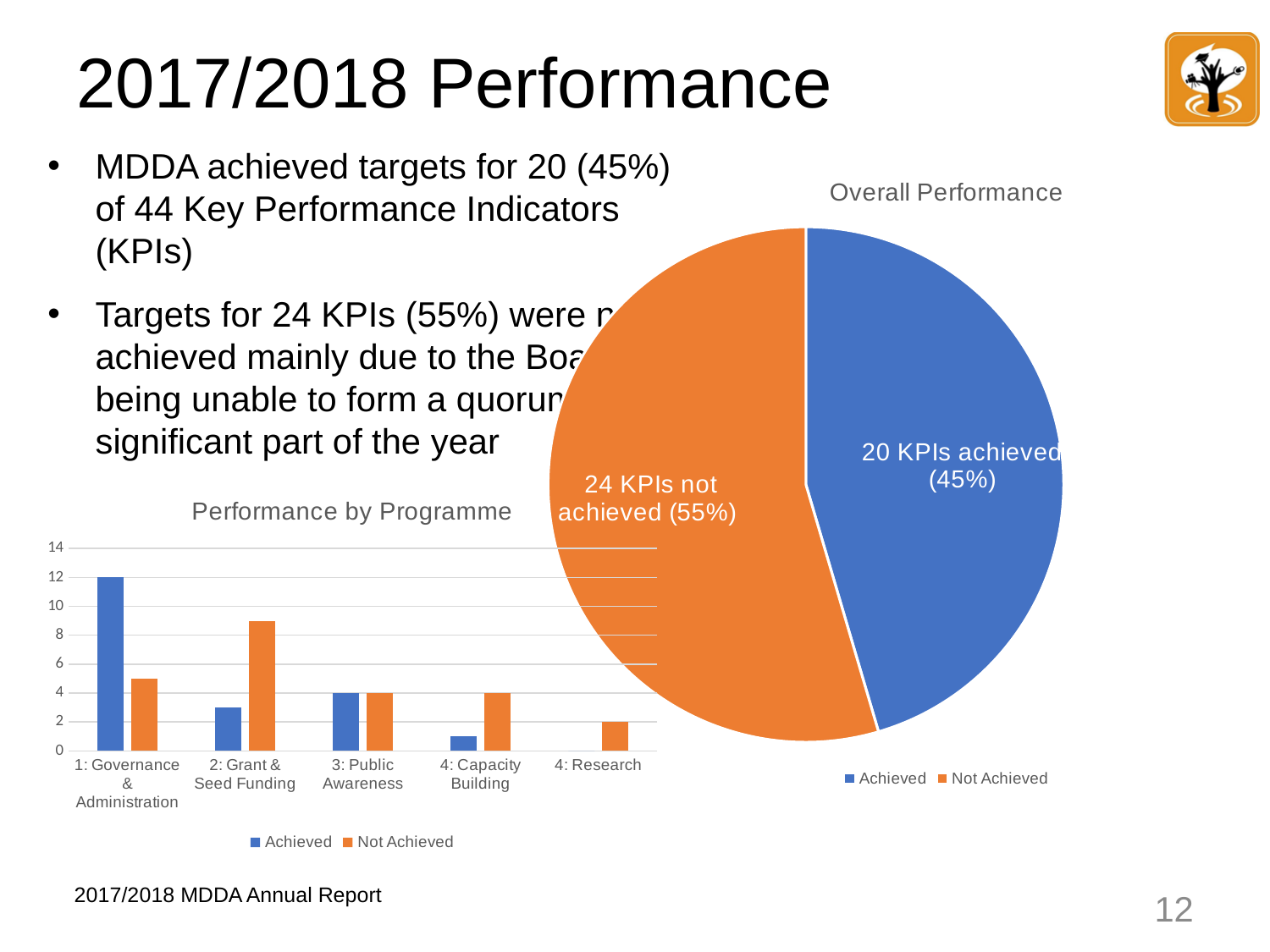
In the Overall Performance pie chart, which slice is larger, Achieved or Not Achieved? Not Achieved In the Performance by Programme chart, is the Not Achieved value for 2: Grant & Seed Funding greater or less than 8? greater In the Overall Performance pie chart, what percentage of KPIs were achieved? 45% How many series does the legend of the Overall Performance chart list? 2 In the Overall Performance pie chart, how many KPIs were not achieved? 24 In the Performance by Programme chart, what is the Achieved value for 3: Public Awareness? 4 In the Performance by Programme chart, what is the Not Achieved value for 4: Research? 2 In the Performance by Programme chart, which programme has the highest Achieved value? 1: Governance & Administration What kind of chart is the Performance by Programme chart? bar chart In the Performance by Programme chart, what is the Achieved value for 1: Governance & Administration? 12 In the Performance by Programme chart, which is larger for 4: Capacity Building, Achieved or Not Achieved? Not Achieved In the Performance by Programme chart, how many programme categories are shown on the x axis? 5